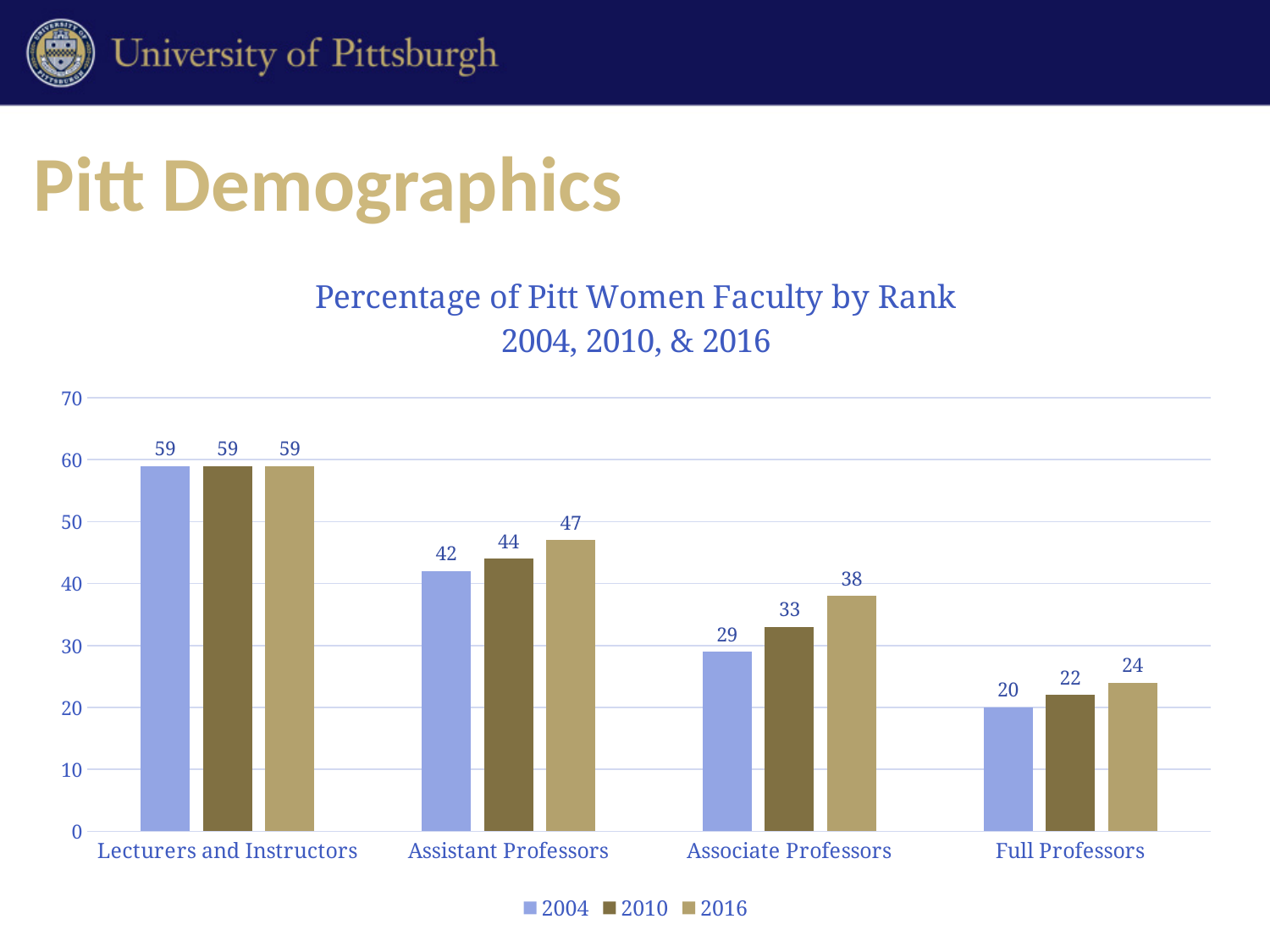
What is the difference between the 2016 and 2004 values for Associate Professors? 9 Which rank has the lowest value in 2004? Full Professors What is the value for Assistant Professors in 2016? 47 Which is larger: the 2010 value for Assistant Professors or the 2016 value for Associate Professors? 2010 value for Assistant Professors What is the title of the chart? Percentage of Pitt Women Faculty by Rank 2004, 2010, & 2016 How many series does the legend list? 3 What is the value for Associate Professors in 2010? 33 How many faculty rank categories are shown on the x axis? 4 What kind of chart is shown? Bar chart What is the value for Full Professors in 2004? 20 Do the 2016 values rise or fall moving from Lecturers and Instructors to Full Professors? Fall Which rank has the highest value in 2016? Lecturers and Instructors